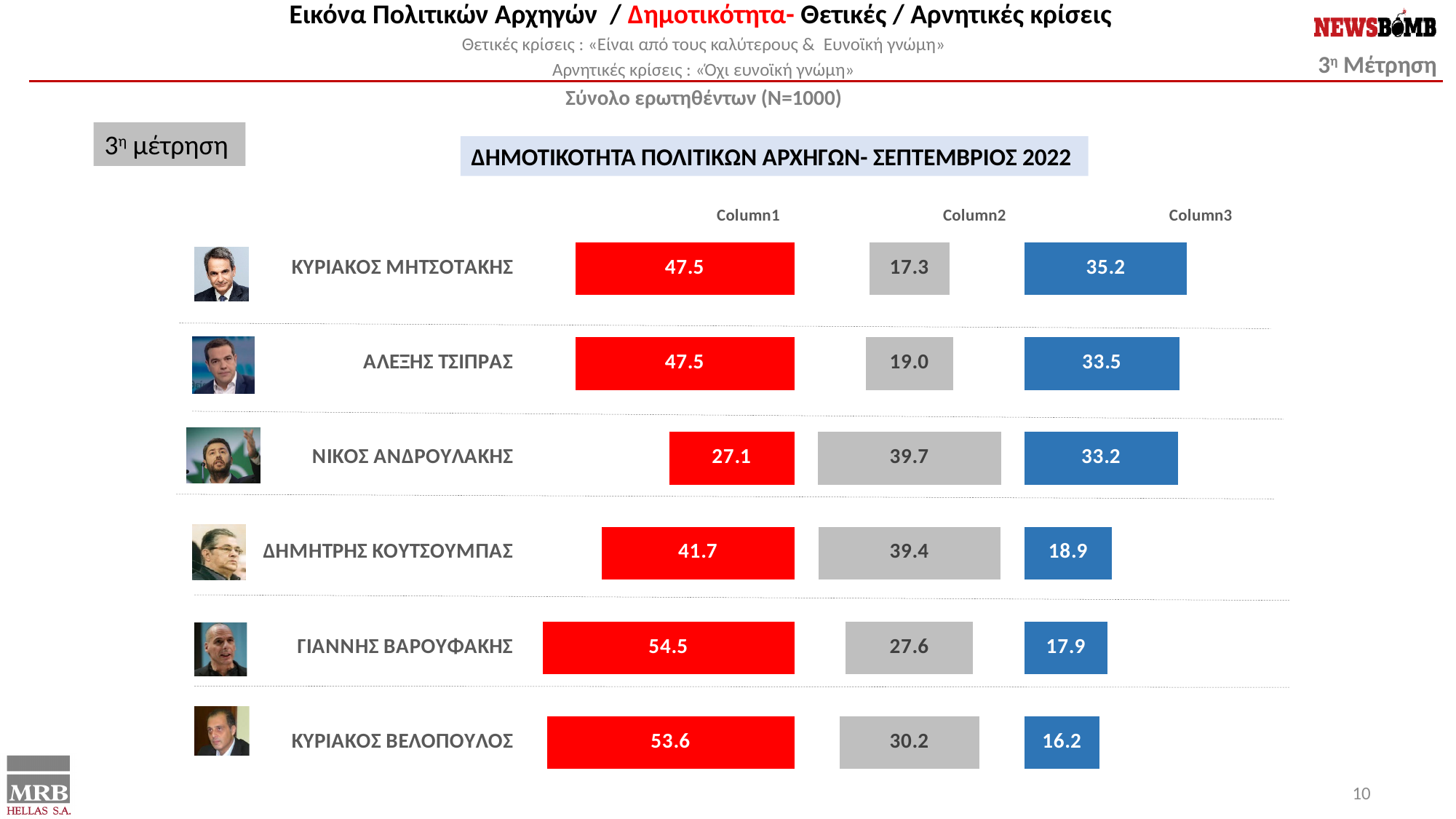
Which politician has the lowest Column1 value? ΝΙΚΟΣ ΑΝΔΡΟΥΛΑΚΗΣ Which is larger: the Column3 value for ΑΛΕΞΗΣ ΤΣΙΠΡΑΣ or the Column3 value for ΔΗΜΗΤΡΗΣ ΚΟΥΤΣΟΥΜΠΑΣ? ΑΛΕΞΗΣ ΤΣΙΠΡΑΣ How many series does the chart show? 3 What is the Column2 value for ΝΙΚΟΣ ΑΝΔΡΟΥΛΑΚΗΣ? 39.7 Which politician has the lowest Column3 value? ΚΥΡΙΑΚΟΣ ΒΕΛΟΠΟΥΛΟΣ What is the Column1 value for ΓΙΑΝΝΗΣ ΒΑΡΟΥΦΑΚΗΣ? 54.5 How many politicians are shown in the chart? 6 What is the Column3 value for ΚΥΡΙΑΚΟΣ ΜΗΤΣΟΤΑΚΗΣ? 35.2 Which politician has the highest Column1 value? ΓΙΑΝΝΗΣ ΒΑΡΟΥΦΑΚΗΣ What is the difference between the Column1 values of ΓΙΑΝΝΗΣ ΒΑΡΟΥΦΑΚΗΣ and ΚΥΡΙΑΚΟΣ ΒΕΛΟΠΟΥΛΟΣ? 0.9 What is the total of the stacked bar for ΚΥΡΙΑΚΟΣ ΜΗΤΣΟΤΑΚΗΣ? 100.0 What kind of chart is shown on the slide? Stacked bar chart